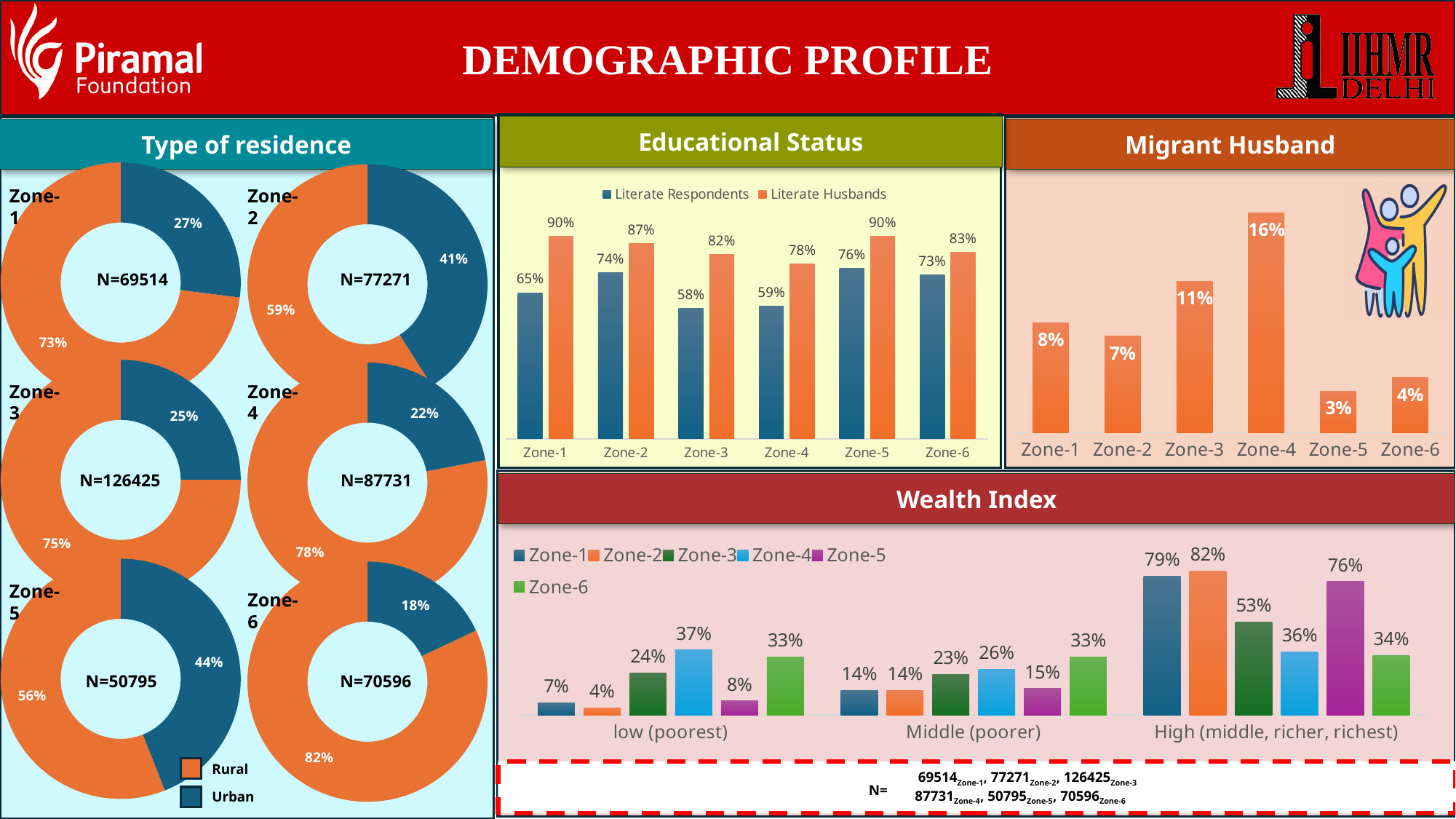
What kind of chart is the Migrant Husband chart? Bar chart How many series does the legend of the Educational Status chart list? 2 How many zones are shown in the Migrant Husband chart? 6 In the Wealth Index chart, which zone has the highest value in the High (middle, richer, richest) category? Zone-2 In the Educational Status chart, what is the value for Literate Husbands in Zone-3? 82% In the Migrant Husband chart, what is the value for Zone-5? 3% In the Migrant Husband chart, which zone has the highest value? Zone-4 In the Type of residence chart, what is the Urban share for Zone-5? 44% In the Educational Status chart, which zone has the lowest value for Literate Respondents? Zone-3 In the Wealth Index chart, what is the value for Zone-4 in the low (poorest) category? 37% In the Wealth Index chart, is the value for Zone-3 or Zone-5 larger in the Middle (poorer) category? Zone-3 In the Educational Status chart, what is the difference between Literate Husbands and Literate Respondents in Zone-1? 25%